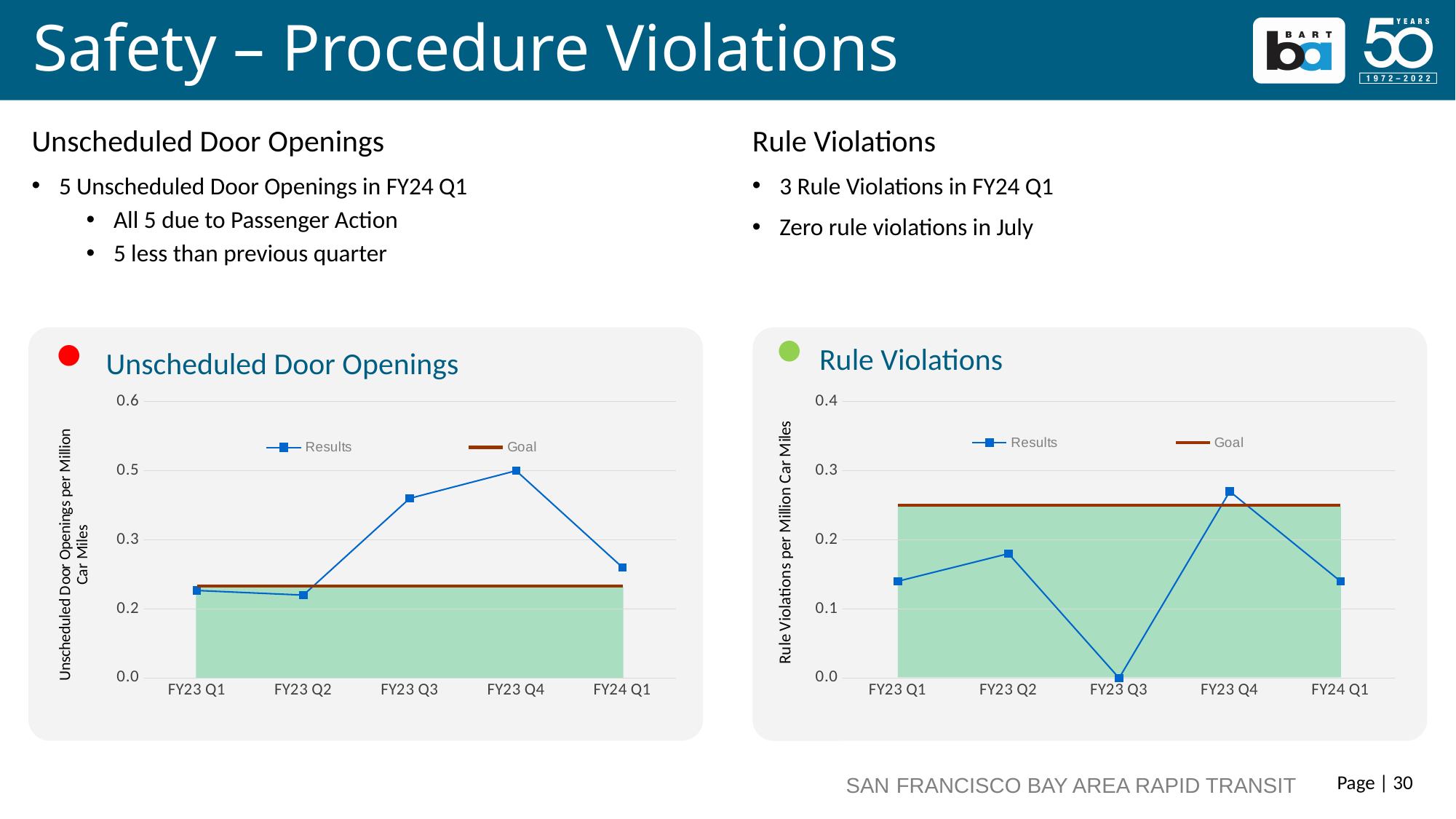
In the Unscheduled Door Openings chart, is the Results value for FY23 Q4 larger or smaller than the value for FY24 Q1? larger In the Unscheduled Door Openings chart, which quarter has the highest Results value? FY23 Q4 What is the y-axis label of the Rule Violations chart? Rule Violations per Million Car Miles How many series does the legend of the Unscheduled Door Openings chart list? 2 In the Unscheduled Door Openings chart, is the Results value for FY23 Q2 greater or less than 0.3? less In the Rule Violations chart, which quarter has the highest Results value? FY23 Q4 In the Rule Violations chart, what is the Results value for FY23 Q3? 0.0 In the Rule Violations chart, which quarter has the lowest Results value? FY23 Q3 In the Rule Violations chart, is the Results value for FY23 Q4 greater or less than 0.2? greater How many quarters are plotted on the x axis of the Rule Violations chart? 5 In the Unscheduled Door Openings chart, is the Results value for FY23 Q3 greater or less than 0.3? greater What kind of chart is the Unscheduled Door Openings chart? line chart